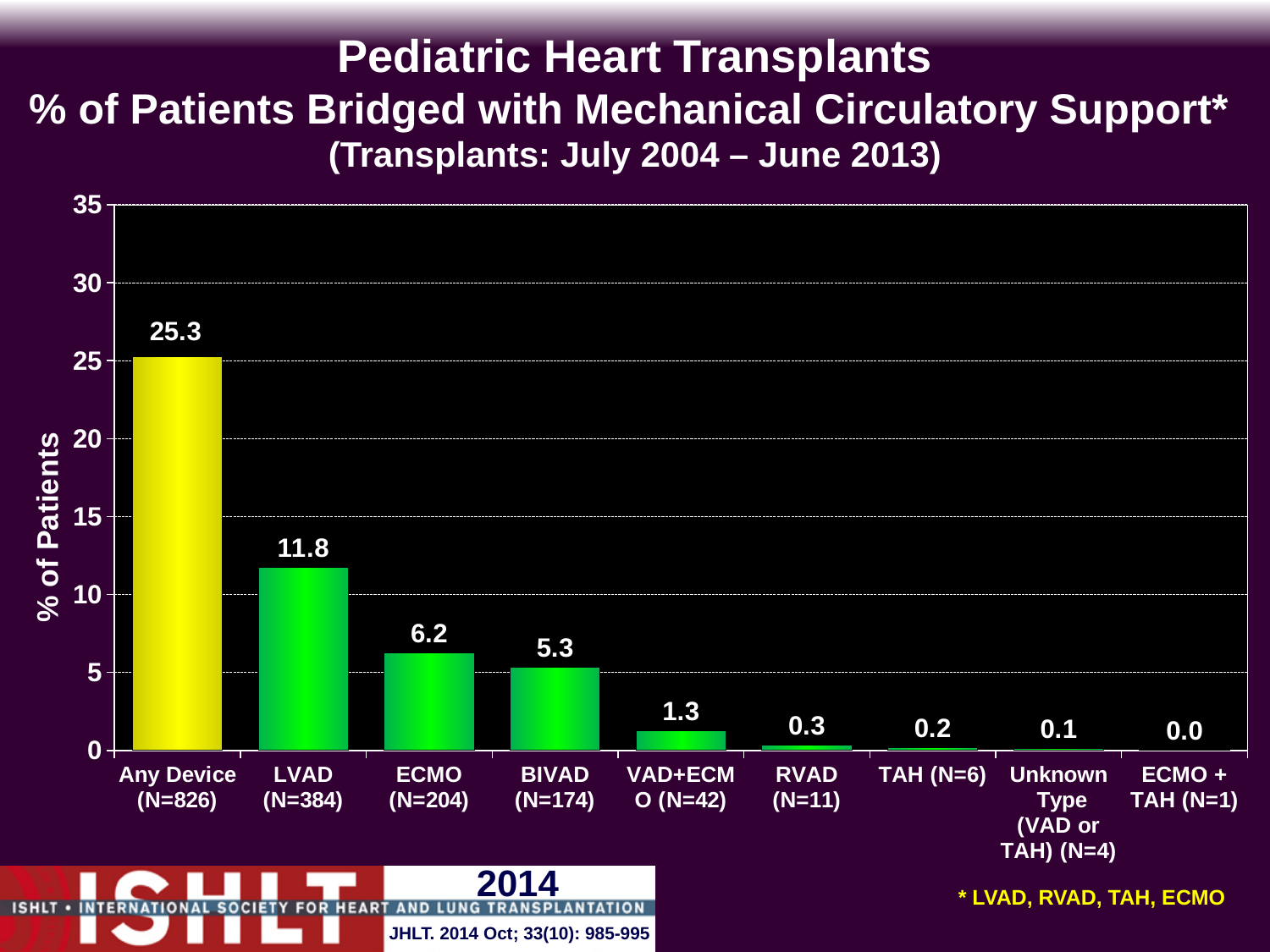
What is the difference between the values for ECMO (N=204) and BIVAD (N=174)? 0.9 Which category has the lowest value? ECMO + TAH (N=1) Is the value for Any Device (N=826) greater or less than 25? greater What is the value for VAD+ECMO (N=42)? 1.3 Which is larger, the value for RVAD (N=11) or the value for TAH (N=6)? RVAD (N=11) What is the value for ECMO (N=204)? 6.2 What is the value for LVAD (N=384)? 11.8 What is the label of the y axis? % of Patients What is the difference between the values for Any Device (N=826) and LVAD (N=384)? 13.5 What kind of chart is shown on the slide? bar chart Which category has the highest value? Any Device (N=826) How many categories are shown on the x axis? 9